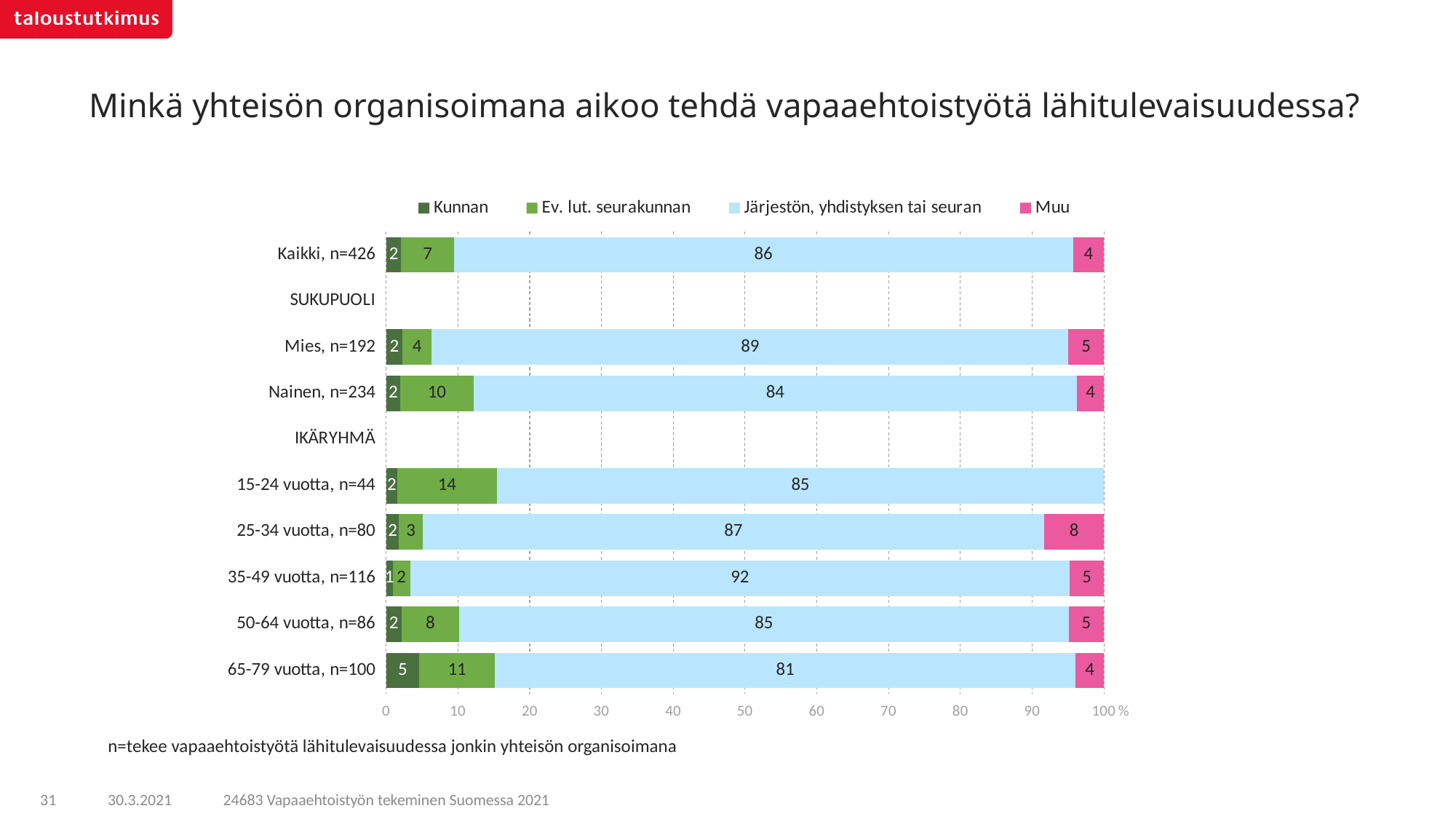
What is the value for "Muu" in the 25-34 vuotta, n=80 bar? 8 What kind of chart is shown on the slide? Stacked bar chart What is the value for "Kunnan" in the 65-79 vuotta, n=100 bar? 5 What is the value for "Ev. lut. seurakunnan" in the Nainen, n=234 bar? 10 Which category has the highest value for "Järjestön, yhdistyksen tai seuran"? 35-49 vuotta, n=116 Which category has the lowest value for "Järjestön, yhdistyksen tai seuran"? 65-79 vuotta, n=100 How many series does the legend list? 4 Which category has the highest value for "Ev. lut. seurakunnan"? 15-24 vuotta, n=44 What is the difference between the "Ev. lut. seurakunnan" values for Nainen, n=234 and Mies, n=192? 6 What is the value for "Järjestön, yhdistyksen tai seuran" in the Kaikki, n=426 bar? 86 What is the total of the stacked bar for Mies, n=192? 100 Which is larger: the "Muu" value for 25-34 vuotta, n=80 or for Mies, n=192? 25-34 vuotta, n=80